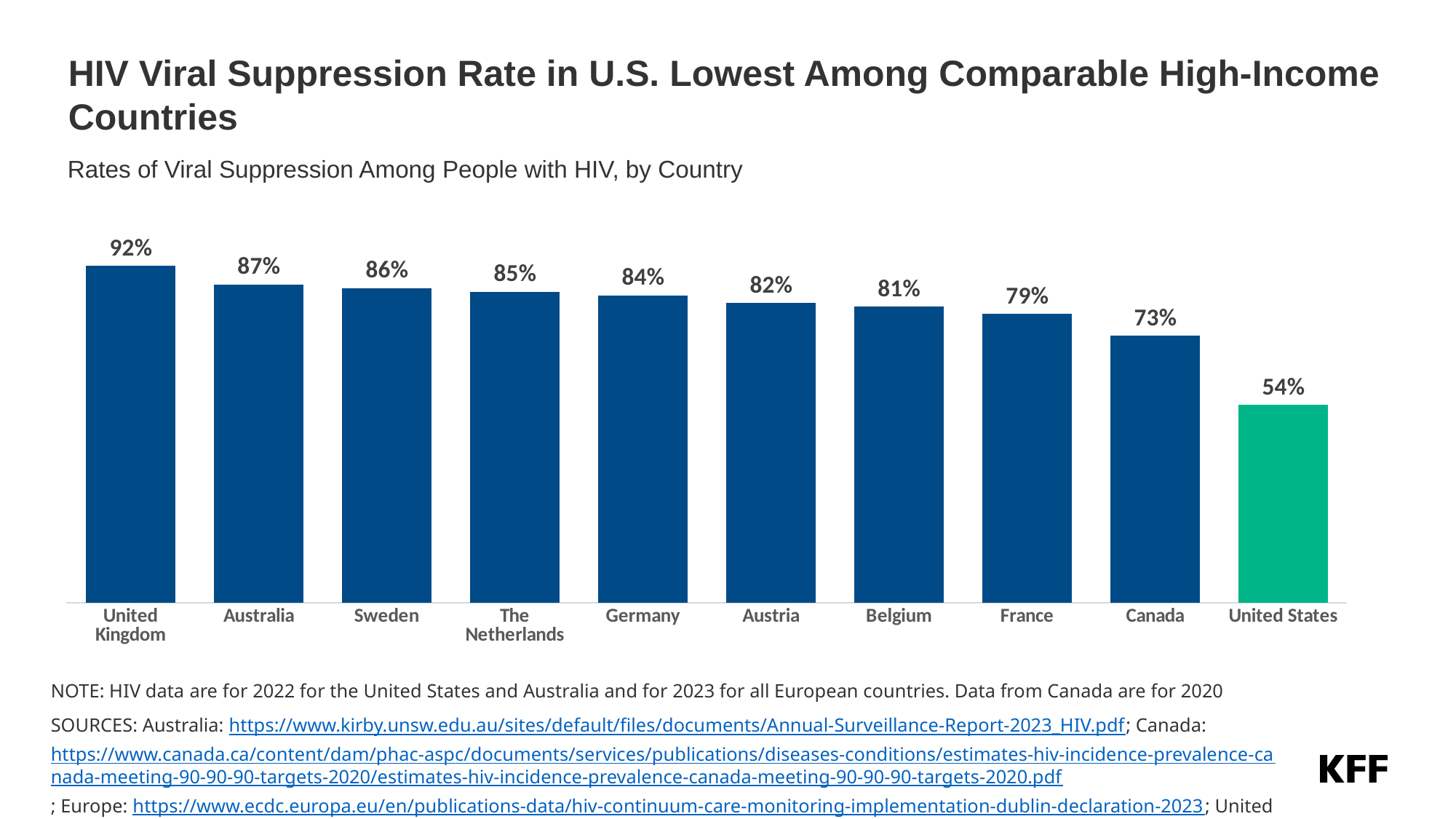
What is the viral suppression rate for Canada? 73% What is the viral suppression rate for the United Kingdom? 92% What is the difference between the viral suppression rates of Canada and the United States? 19 percentage points What is the difference between the viral suppression rates of the United Kingdom and the United States? 38 percentage points Do the values rise or fall moving from left to right across the chart? Fall Which country's bar is shown in a different colour (green) from the others? United States Which country has the lowest viral suppression rate? United States How many countries are shown in the chart? 10 What is the viral suppression rate for the United States? 54% Which country has the highest viral suppression rate? United Kingdom What kind of chart is shown on the slide? Bar chart Which has a higher viral suppression rate, Germany or France? Germany